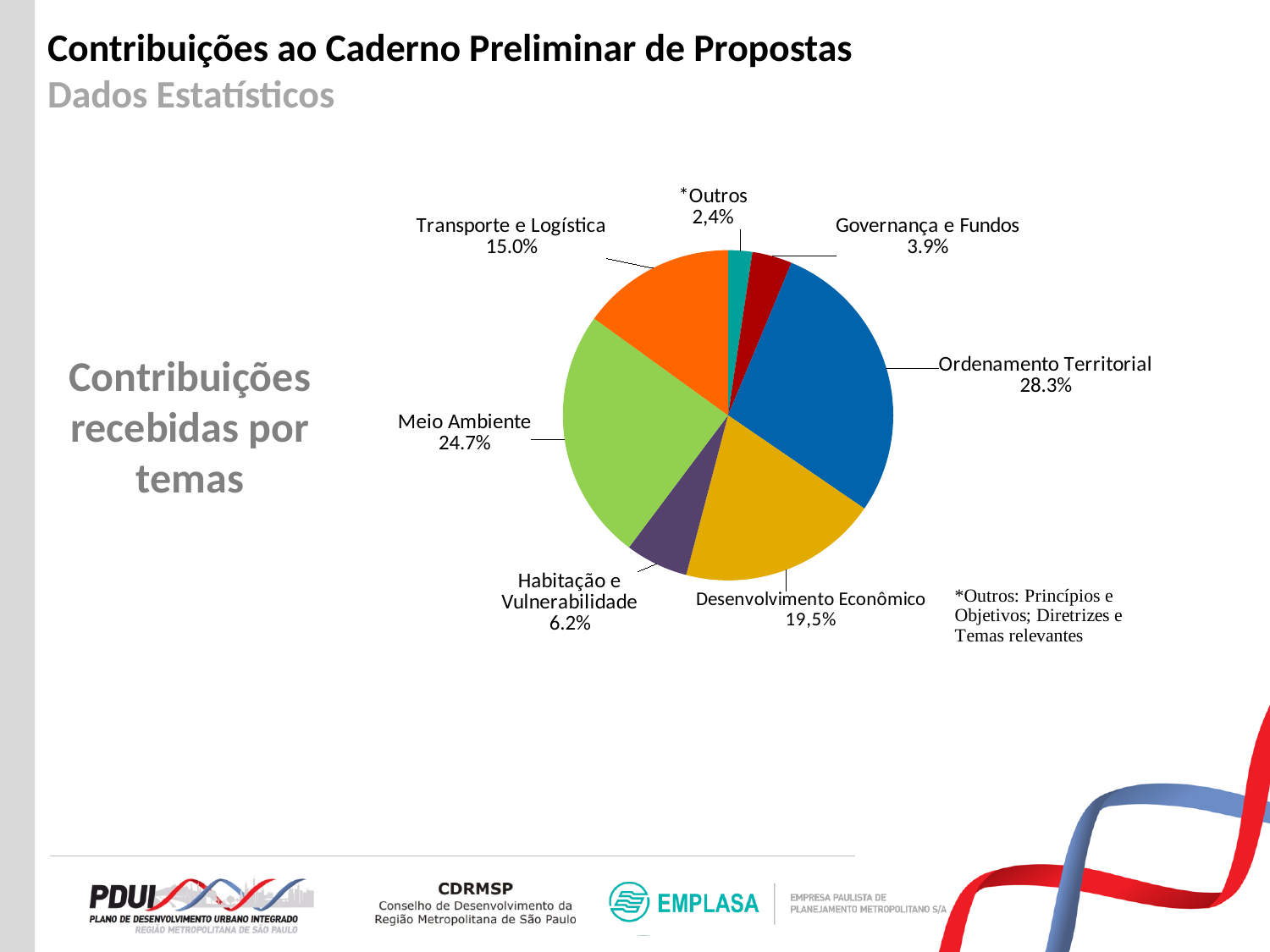
What percentage is shown for Habitação e Vulnerabilidade? 6.2% What percentage is shown for Meio Ambiente? 24.7% What percentage of contributions does the Ordenamento Territorial slice represent? 28.3% What type of chart is shown on the slide? Pie chart What value is labelled on the Desenvolvimento Econômico slice? 19,5% What percentage is shown for Transporte e Logística? 15.0% What colour is the Meio Ambiente slice? Green Which theme received the smallest share of contributions? Outros How many slices does the pie chart have? 7 What percentage is shown for Governança e Fundos? 3.9% Which slice is larger: Meio Ambiente or Desenvolvimento Econômico? Meio Ambiente Which theme received the largest share of contributions? Ordenamento Territorial